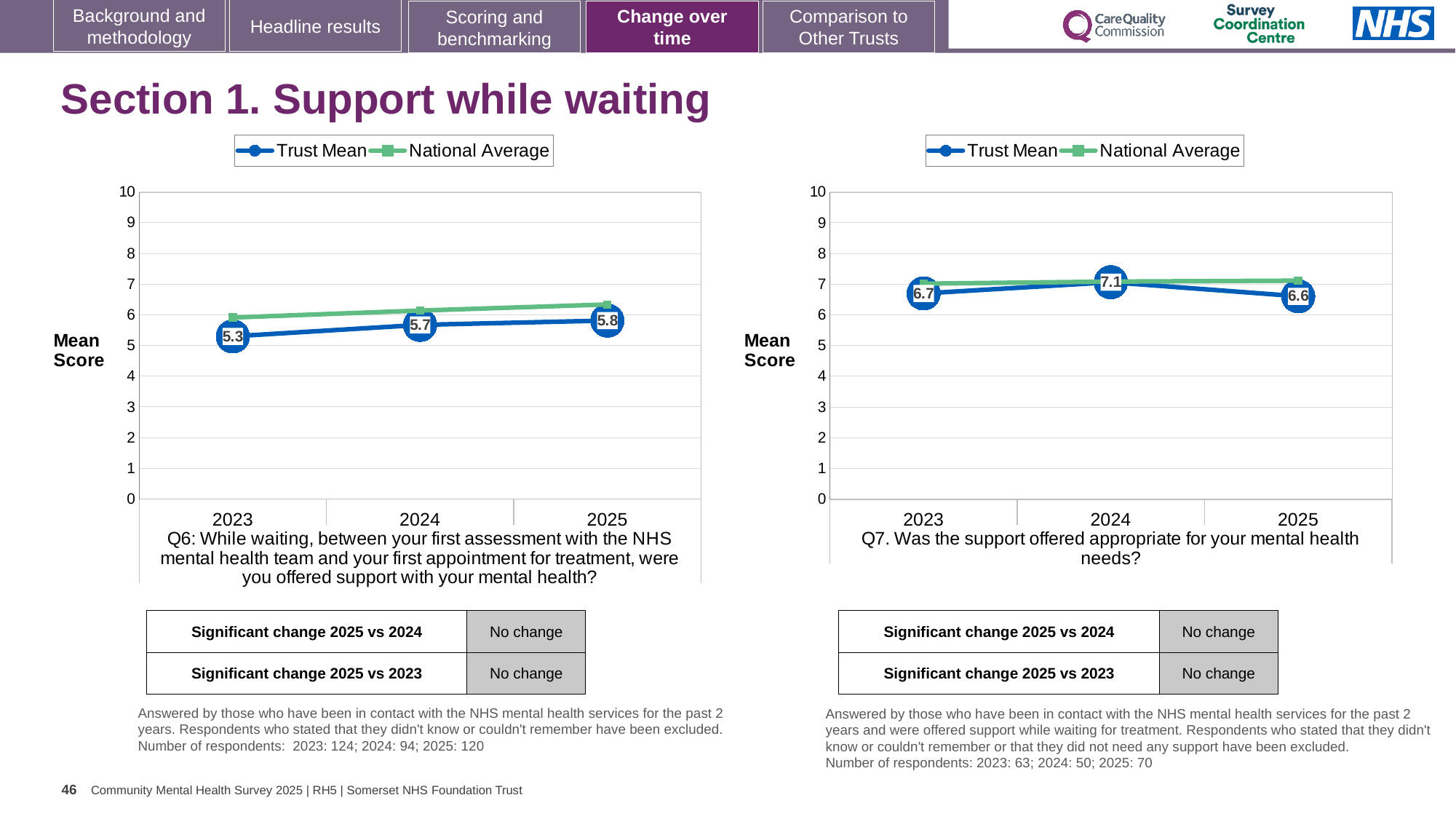
In the left chart (Q6), in 2023 which series is higher, Trust Mean or National Average? National Average In the right chart (Q7), which year has the highest Trust Mean score? 2024 In the right chart (Q7), what is the Trust Mean score for 2024? 7.1 In the left chart (Q6), does the Trust Mean rise or fall from 2023 to 2025? rise In the left chart (Q6), what is the Trust Mean score for 2023? 5.3 In the left chart (Q6), what is the difference between the Trust Mean scores for 2025 and 2023? 0.5 How many series does the legend of the right chart (Q7) list? 2 In the right chart (Q7), what is the difference between the Trust Mean scores for 2024 and 2025? 0.5 In the left chart (Q6), which year has the lowest Trust Mean score? 2023 In the left chart (Q6), what is the Trust Mean score for 2025? 5.8 In the right chart (Q7), what is the Trust Mean score for 2025? 6.6 What kind of chart is the left chart (Q6)? line chart